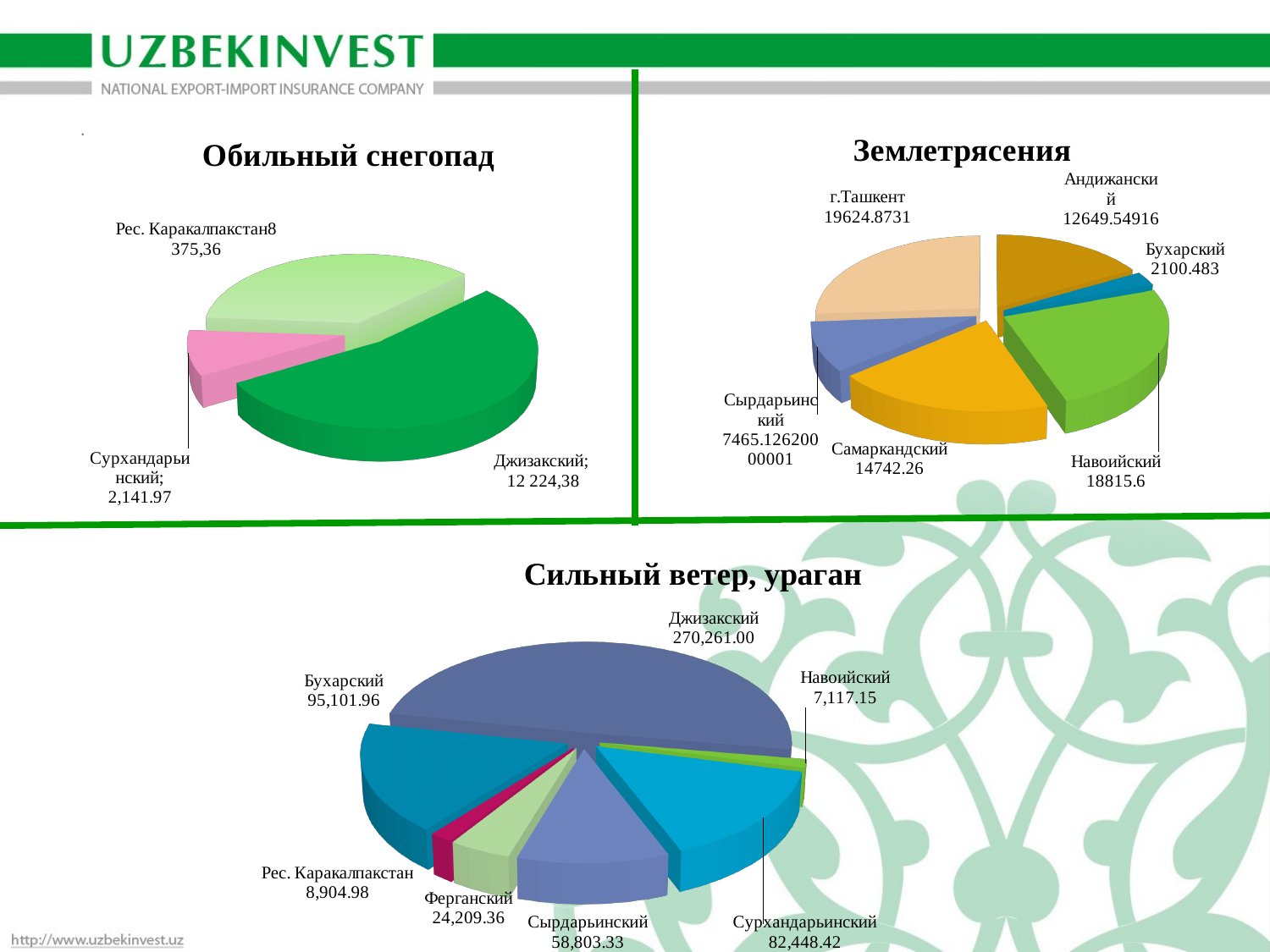
In the "Обильный снегопад" chart, what is the value for Джизакский? 12 224,38 How many slices does the "Землетрясения" pie chart have? 6 In the "Сильный ветер, ураган" chart, what is the value for Ферганский? 24,209.36 What kind of chart is used for "Обильный снегопад"? pie chart In the "Сильный ветер, ураган" chart, which is larger: Бухарский or Сурхандарьинский? Бухарский In the "Землетрясения" chart, what is the value for Самаркандский? 14742.26 How many slices does the "Обильный снегопад" pie chart have? 3 In the "Землетрясения" chart, which region has the highest value? г.Ташкент In the "Сильный ветер, ураган" chart, what is the difference between Бухарский and Сурхандарьинский? 12,653.54 In the "Обильный снегопад" chart, what is the value for Сурхандарьинский? 2,141.97 In the "Землетрясения" chart, which region has the lowest value? Бухарский In the "Сильный ветер, ураган" chart, which region has the highest value? Джизакский